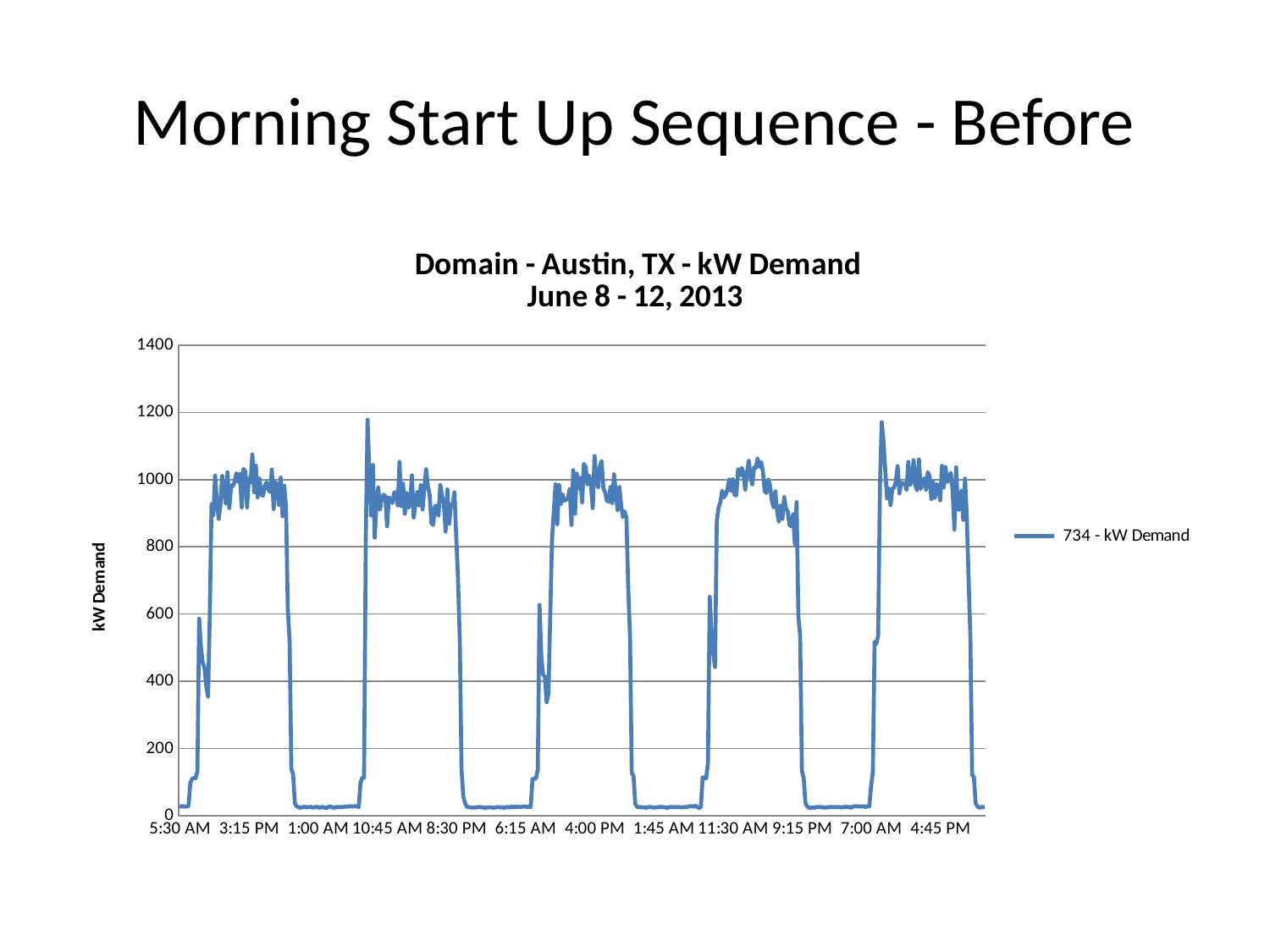
Is the highest value reached by the kW Demand line greater or less than 1000? greater Is the highest value reached by the kW Demand line greater or less than 1400? less What is the title of the chart? Domain - Austin, TX - kW Demand June 8 - 12, 2013 Does the kW Demand line show a steady rise, a steady fall, or repeating cycles across the x axis? repeating cycles How many high-demand plateaus (daily cycles) does the line show? 5 Is the lowest value reached by the kW Demand line greater or less than 200? less What is the legend entry for the plotted series? 734 - kW Demand How many series does the legend list? 1 How many time labels are shown along the x axis? 12 What kind of chart is shown on the slide? line chart